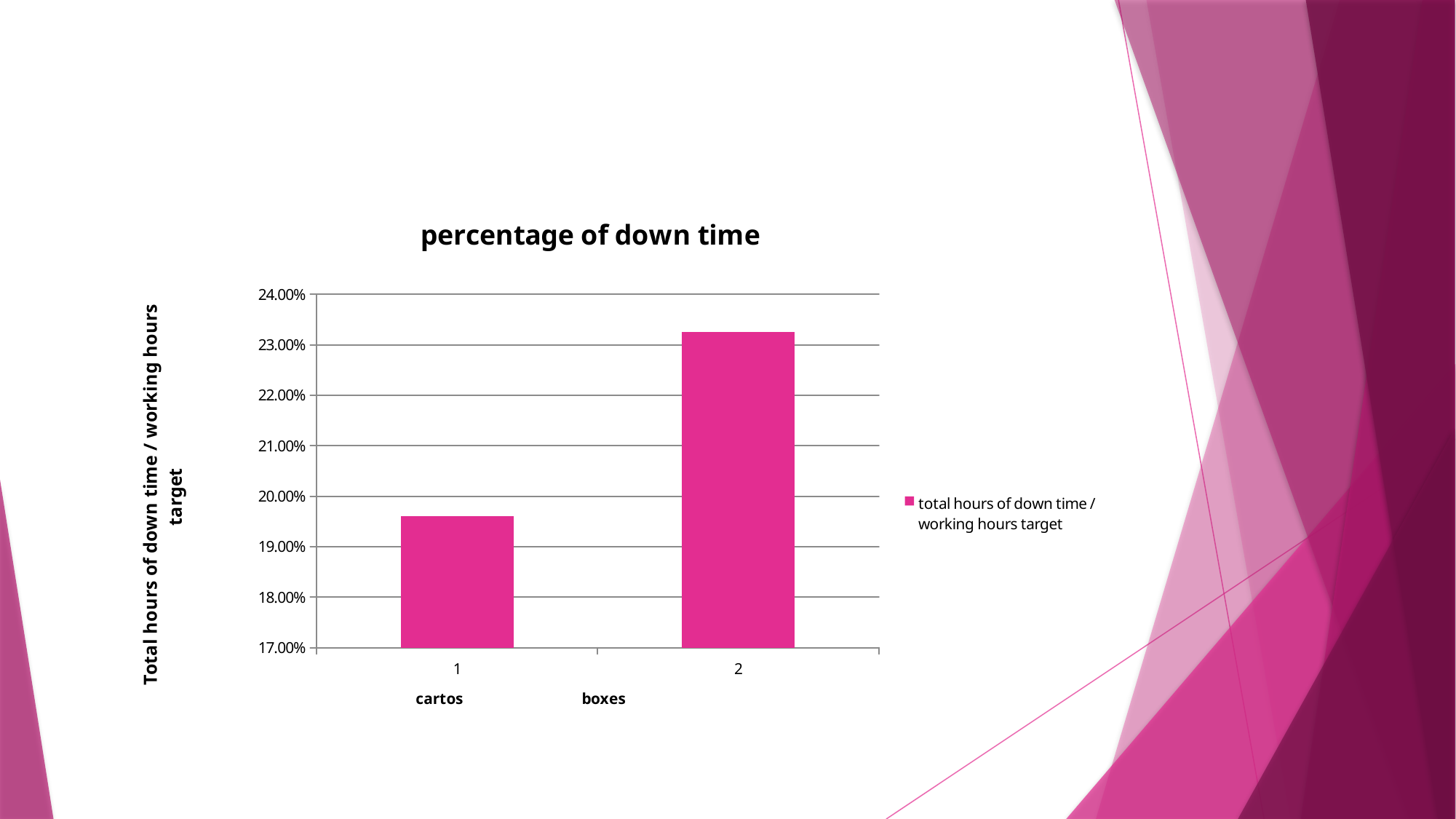
Is the value for cartos greater or less than 20.00%? less Is the value for boxes greater or less than 23.00%? greater What is the legend entry for the series in the chart? total hours of down time / working hours target What kind of chart is shown on the slide? bar chart Do the values rise or fall from cartos to boxes along the x axis? rise Which category has the highest percentage of down time? boxes How many series does the legend list? 1 Is the value for cartos greater or less than 19.00%? greater What is the title of the chart? percentage of down time How many bars are plotted in the chart? 2 Which category has the lowest percentage of down time? cartos Which has a larger percentage of down time, cartos or boxes? boxes